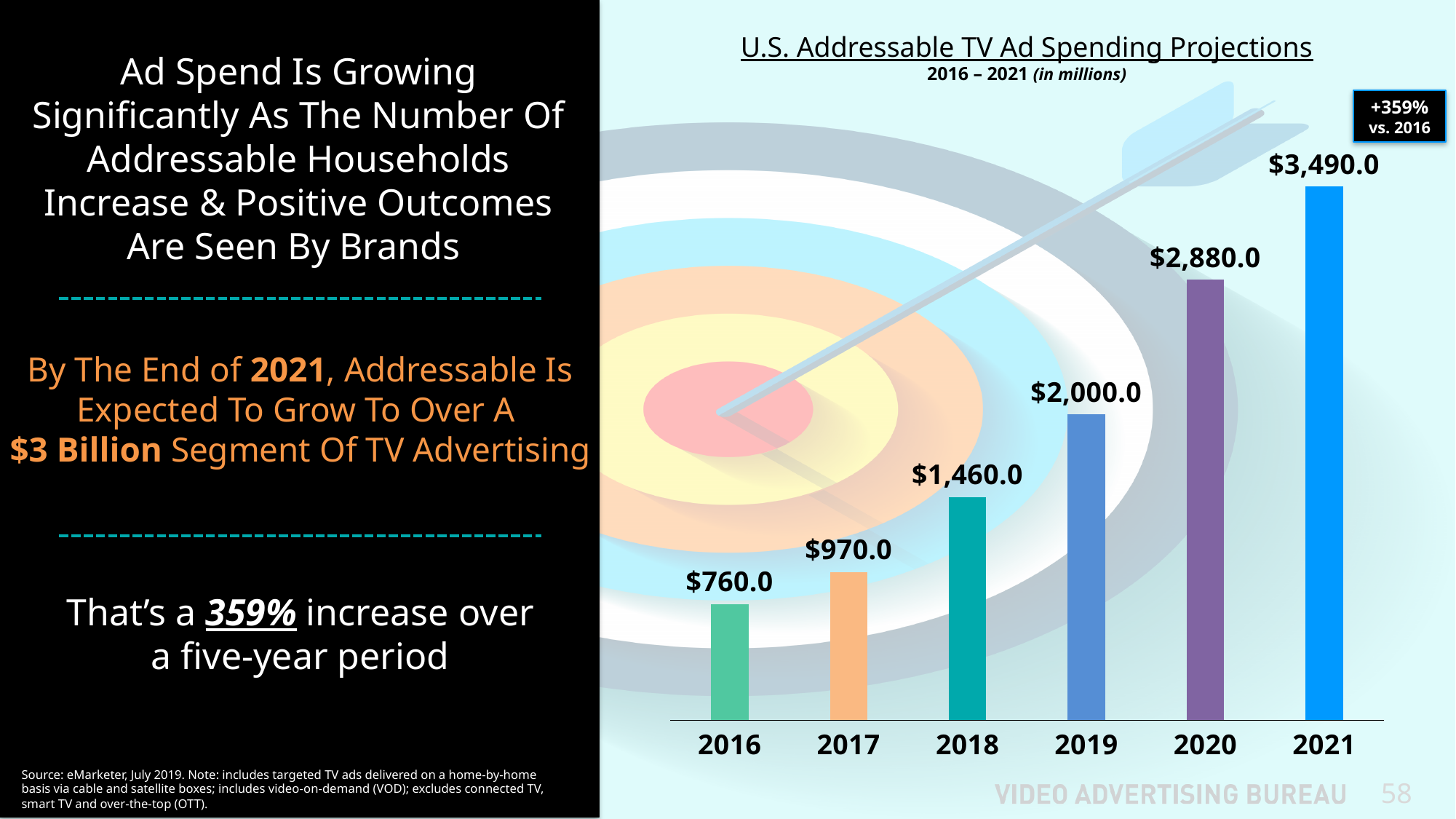
Which is larger, the value for 2017 or the value for 2019? 2019 What is the value shown for 2020? $2,880.0 What is the projected U.S. addressable TV ad spending for 2018? $1,460.0 What is the difference between the 2019 and 2018 values? $540.0 What is the title of the chart? U.S. Addressable TV Ad Spending Projections Do the values rise or fall from 2016 to 2021? Rise What is the difference between the 2021 and 2016 values? $2,730.0 What kind of chart is shown on the slide? Bar chart Which year has the highest projected ad spending? 2021 Which year has the lowest projected ad spending? 2016 What is the value shown for 2016? $760.0 How many years are shown on the x axis? 6